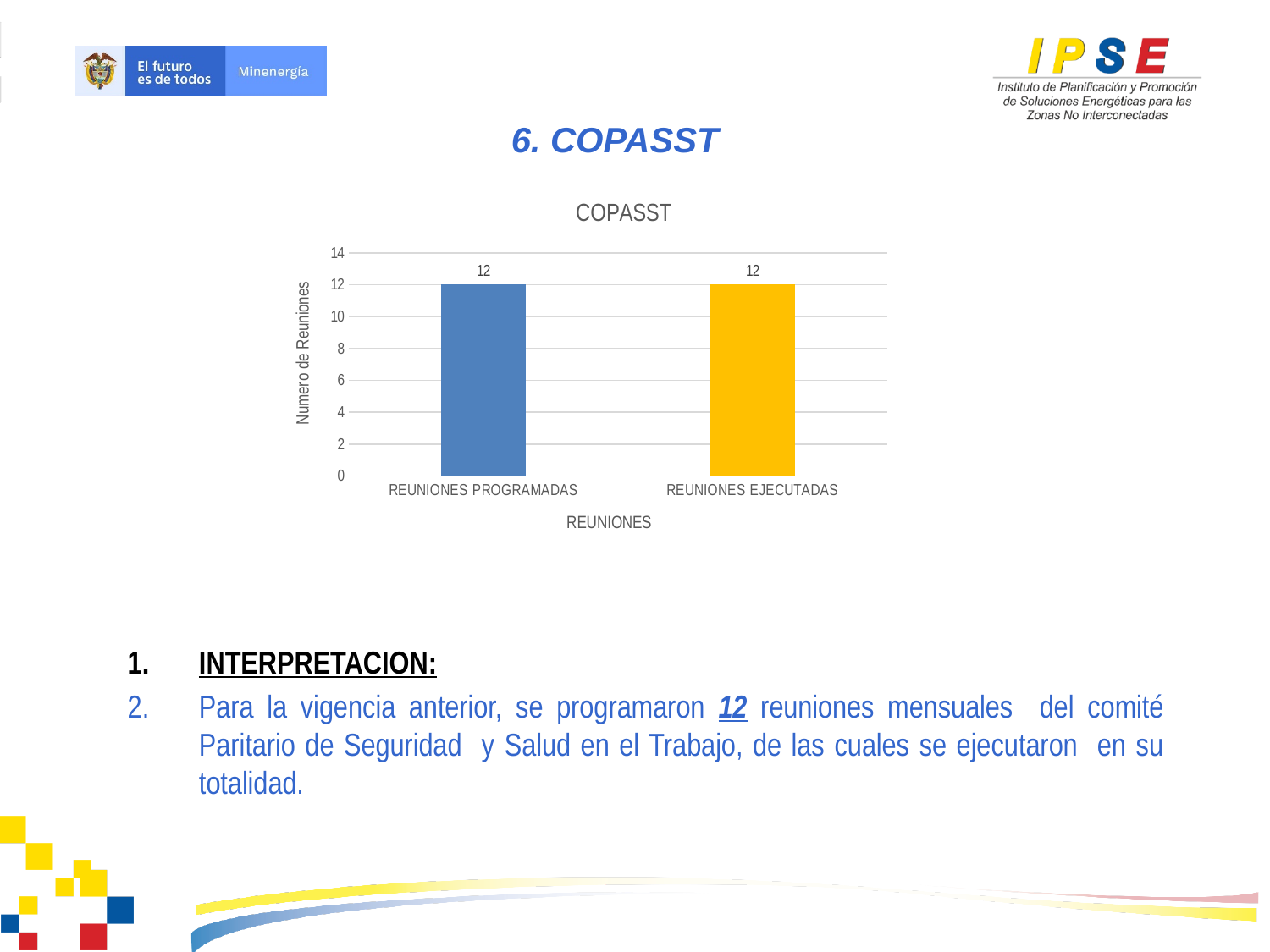
How many categories are shown on the x axis of the COPASST chart? 2 What is the title of the chart on the slide? COPASST What is the total of the two bars in the COPASST chart? 24 What kind of chart is the COPASST chart? bar chart What is the difference between REUNIONES PROGRAMADAS and REUNIONES EJECUTADAS in the COPASST chart? 0 Is the value for REUNIONES EJECUTADAS greater or less than 10? greater What is the highest value shown on the vertical axis of the COPASST chart? 14 Is the value for REUNIONES PROGRAMADAS greater or less than 14? less What is the value for REUNIONES PROGRAMADAS in the COPASST chart? 12 What is the value for REUNIONES EJECUTADAS in the COPASST chart? 12 What is the label of the vertical axis of the COPASST chart? Numero de Reuniones